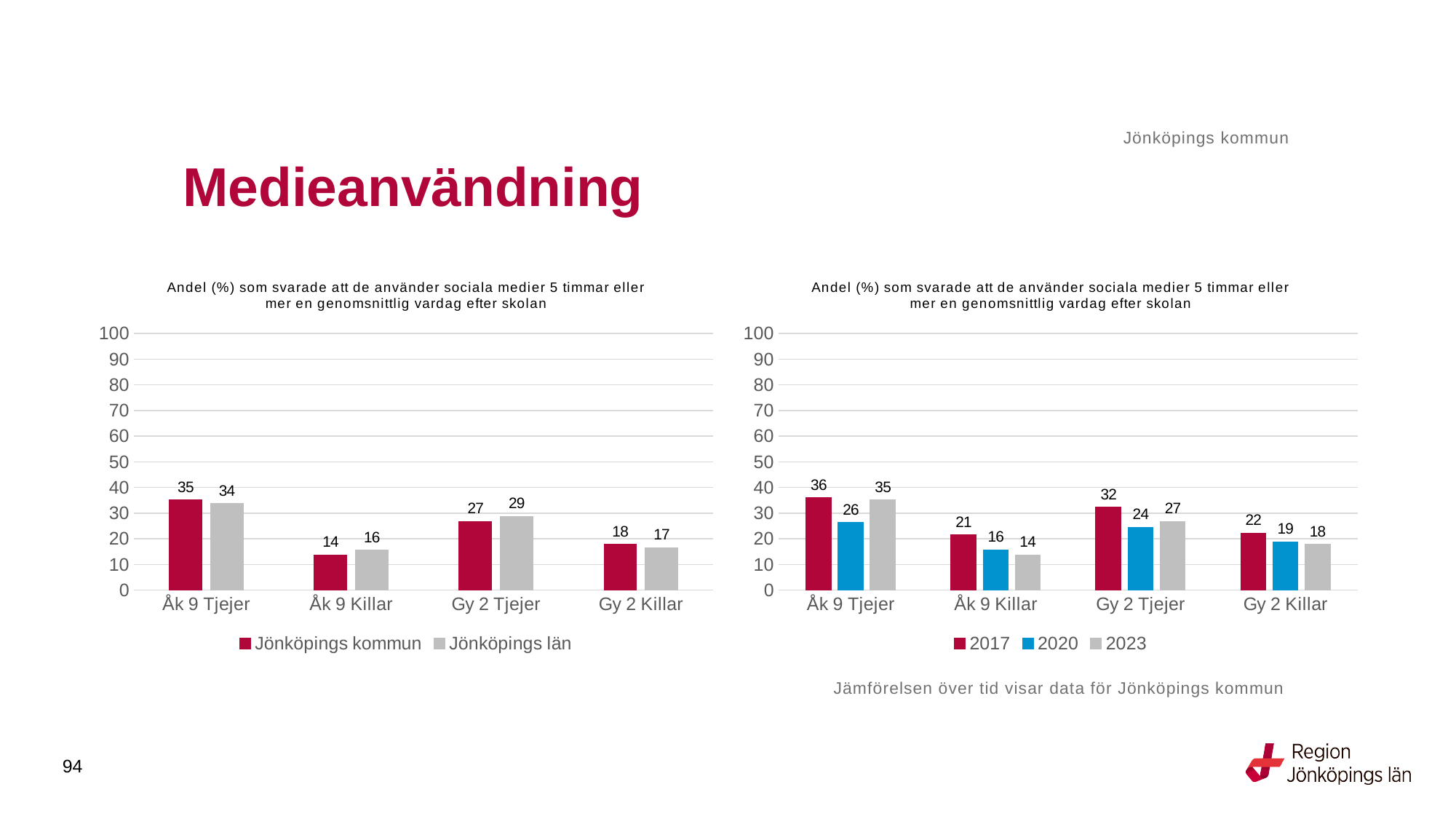
In the left chart, what is the value for Jönköpings kommun for Åk 9 Tjejer? 35 In the right chart, how many categories are shown on the x axis? 4 In the left chart, what is the value for Jönköpings län for Gy 2 Tjejer? 29 In the right chart, what is the value for 2020 for Gy 2 Tjejer? 24 In the left chart, what is the difference between Jönköpings län and Jönköpings kommun for Åk 9 Killar? 2 What kind of chart is the right chart? Bar chart In the left chart, how many series does the legend list? 2 In the right chart, what is the difference between 2017 and 2023 for Åk 9 Killar? 7 In the right chart, is the value for 2017 for Åk 9 Tjejer larger or the value for 2020 for Åk 9 Tjejer? 2017 In the right chart, what is the value for 2017 for Gy 2 Killar? 22 In the left chart, which category has the lowest value for Jönköpings kommun? Åk 9 Killar In the right chart, which category has the highest value for 2023? Åk 9 Tjejer